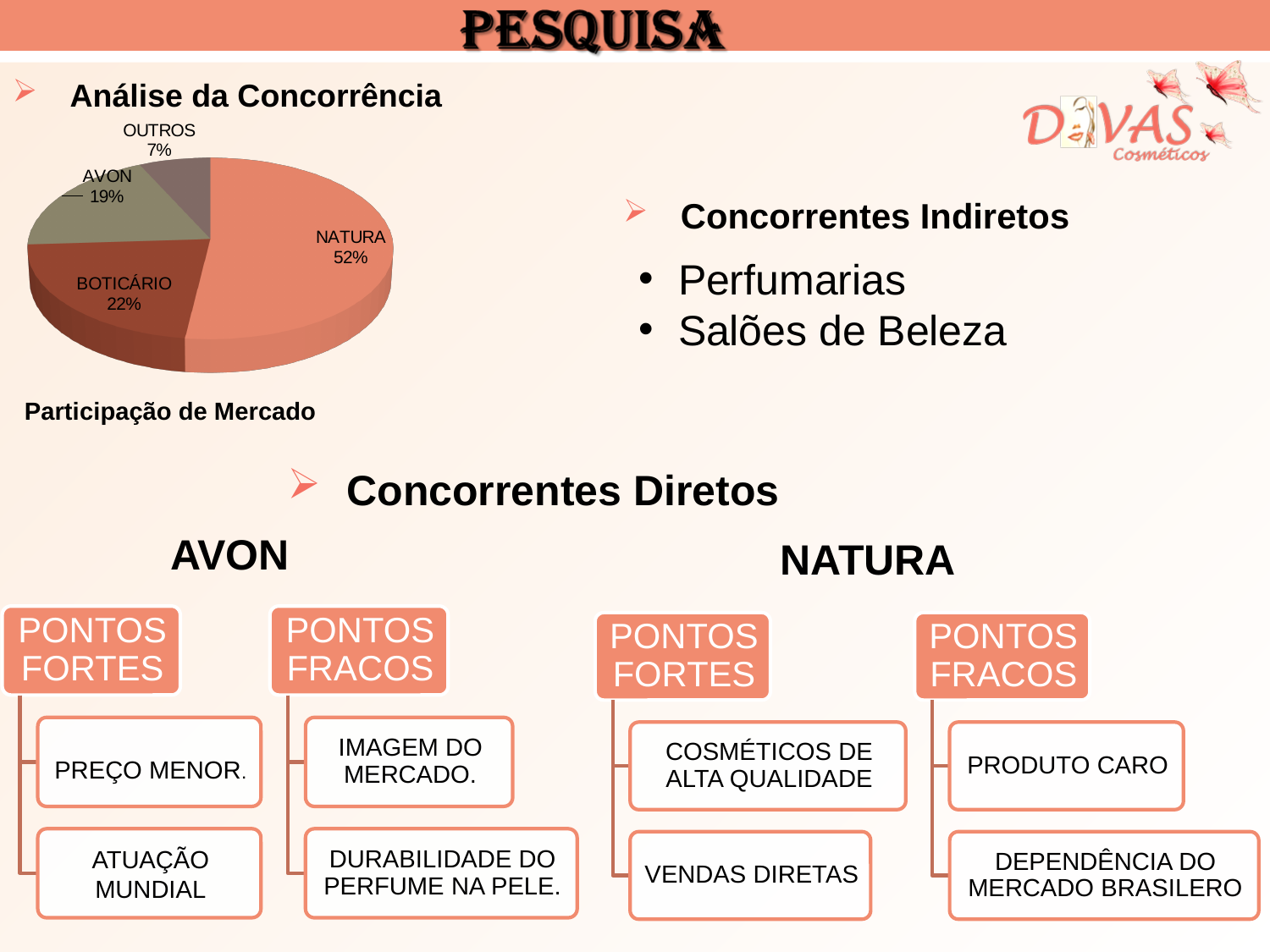
How many slices does the pie chart have? 4 What share of the market does NATURA hold in the pie chart? 52% What share of the market does BOTICÁRIO hold in the pie chart? 22% Which category has the largest slice in the pie chart? NATURA Which has a larger share, BOTICÁRIO or AVON? BOTICÁRIO What is the combined share of AVON and OUTROS in the pie chart? 26% What kind of chart is shown on the slide? Pie chart What share of the market does AVON hold in the pie chart? 19% What is the difference in percentage points between NATURA's and BOTICÁRIO's shares? 30 What is the caption below the pie chart? Participação de Mercado What share of the market does OUTROS hold in the pie chart? 7% Which category has the smallest slice in the pie chart? OUTROS